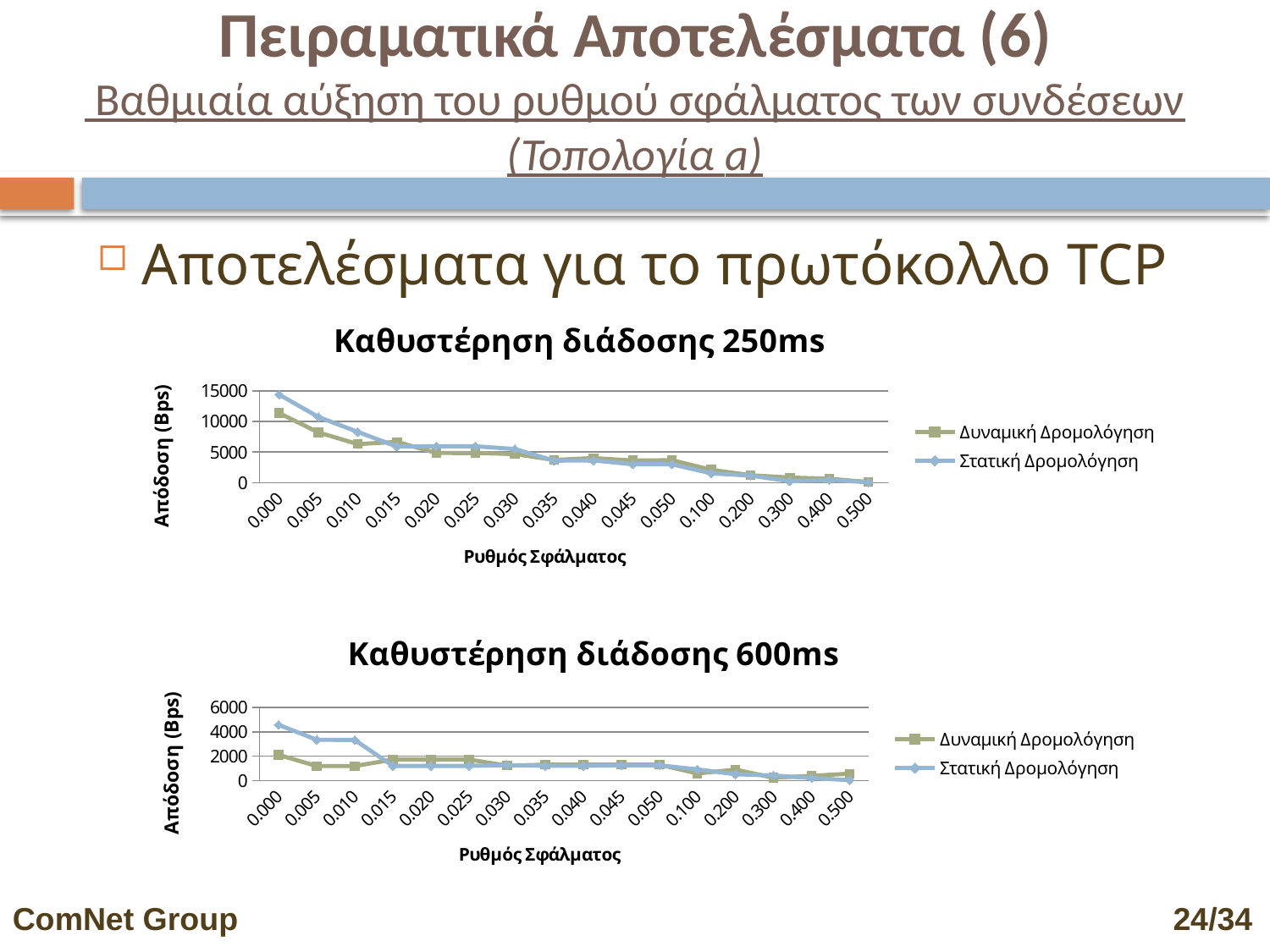
What is the label of the x axis on the 'Καθυστέρηση διάδοσης 600ms' chart? Ρυθμός Σφάλματος How many series does the legend of the 'Καθυστέρηση διάδοσης 600ms' chart list? 2 In the 'Καθυστέρηση διάδοσης 600ms' chart, which series has the larger value at error rate 0.010? Στατική Δρομολόγηση In the 'Καθυστέρηση διάδοσης 250ms' chart, which series has the larger value at error rate 0.000? Στατική Δρομολόγηση In the 'Καθυστέρηση διάδοσης 250ms' chart, is the value for Στατική Δρομολόγηση at error rate 0.000 greater or less than 10000? greater In the 'Καθυστέρηση διάδοσης 600ms' chart, is the value for Στατική Δρομολόγηση at error rate 0.000 greater or less than 4000? greater In the 'Καθυστέρηση διάδοσης 250ms' chart, is the value for Δυναμική Δρομολόγηση at error rate 0.500 greater or less than 5000? less In the 'Καθυστέρηση διάδοσης 250ms' chart, do the values of Στατική Δρομολόγηση rise or fall as the error rate increases along the x axis? fall How many error-rate categories are shown on the x axis of the 'Καθυστέρηση διάδοσης 250ms' chart? 16 In the 'Καθυστέρηση διάδοσης 250ms' chart, at which error rate does Στατική Δρομολόγηση reach its highest value? 0.000 In the 'Καθυστέρηση διάδοσης 600ms' chart, do the values of Στατική Δρομολόγηση rise or fall as the error rate increases along the x axis? fall What kind of chart is the 'Καθυστέρηση διάδοσης 250ms' chart? line chart